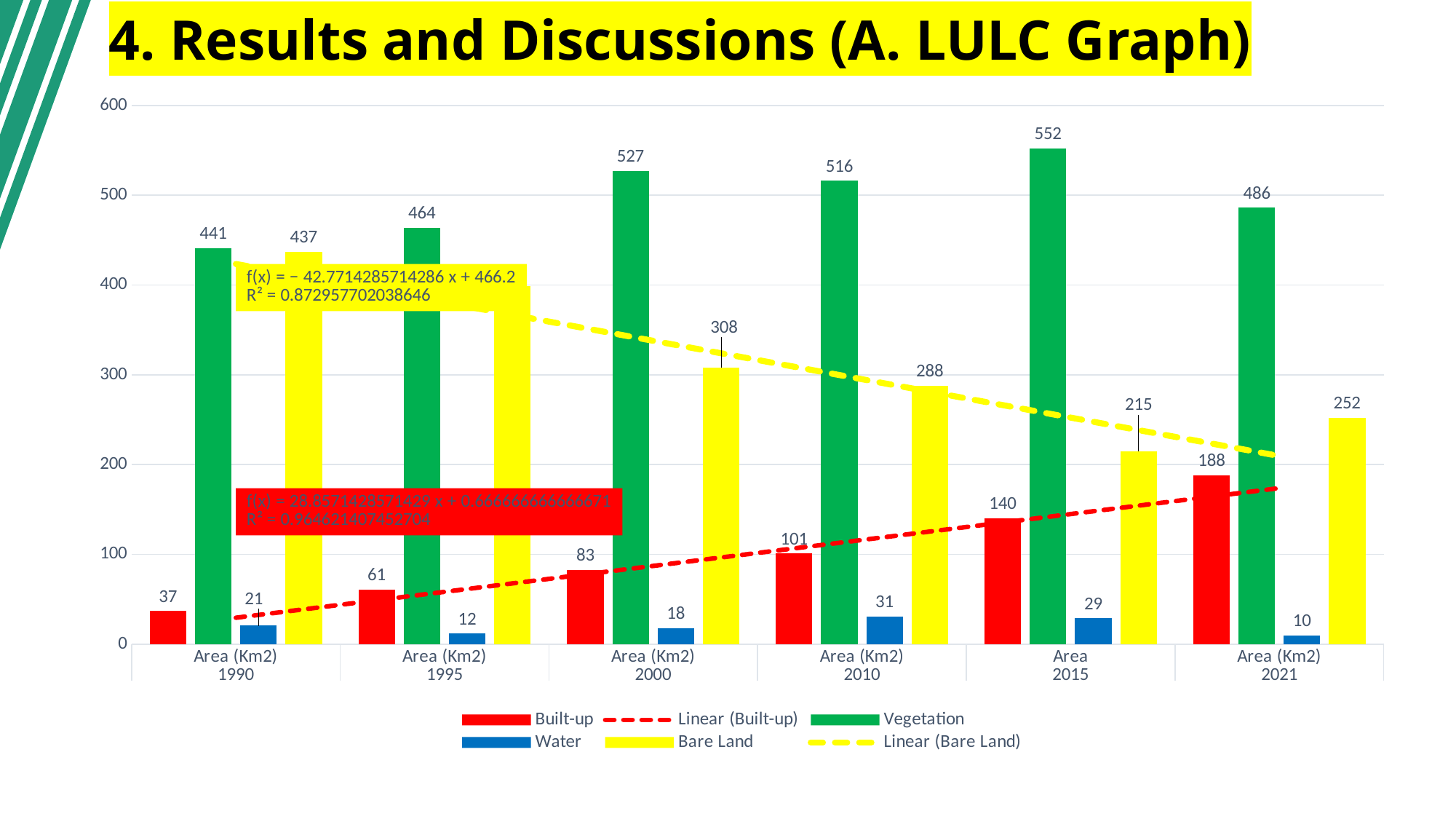
How many entries does the legend list? 6 What is the Built-up area value for 2021? 188 How many year categories are shown on the x axis? 6 What is the difference between the Built-up values for 2021 and 1990? 151 In which year is the Vegetation value highest? 2015 Which is larger, the Bare Land value for 2000 or the Bare Land value for 2010? Bare Land value for 2000 In which year is the Water value lowest? 2021 Do the Built-up values rise or fall from 1990 to 2021? Rise What is the Bare Land value for 1990? 437 What kind of chart is shown on the slide? Bar chart What is the Water value for 2010? 31 What is the Vegetation value for 2015? 552